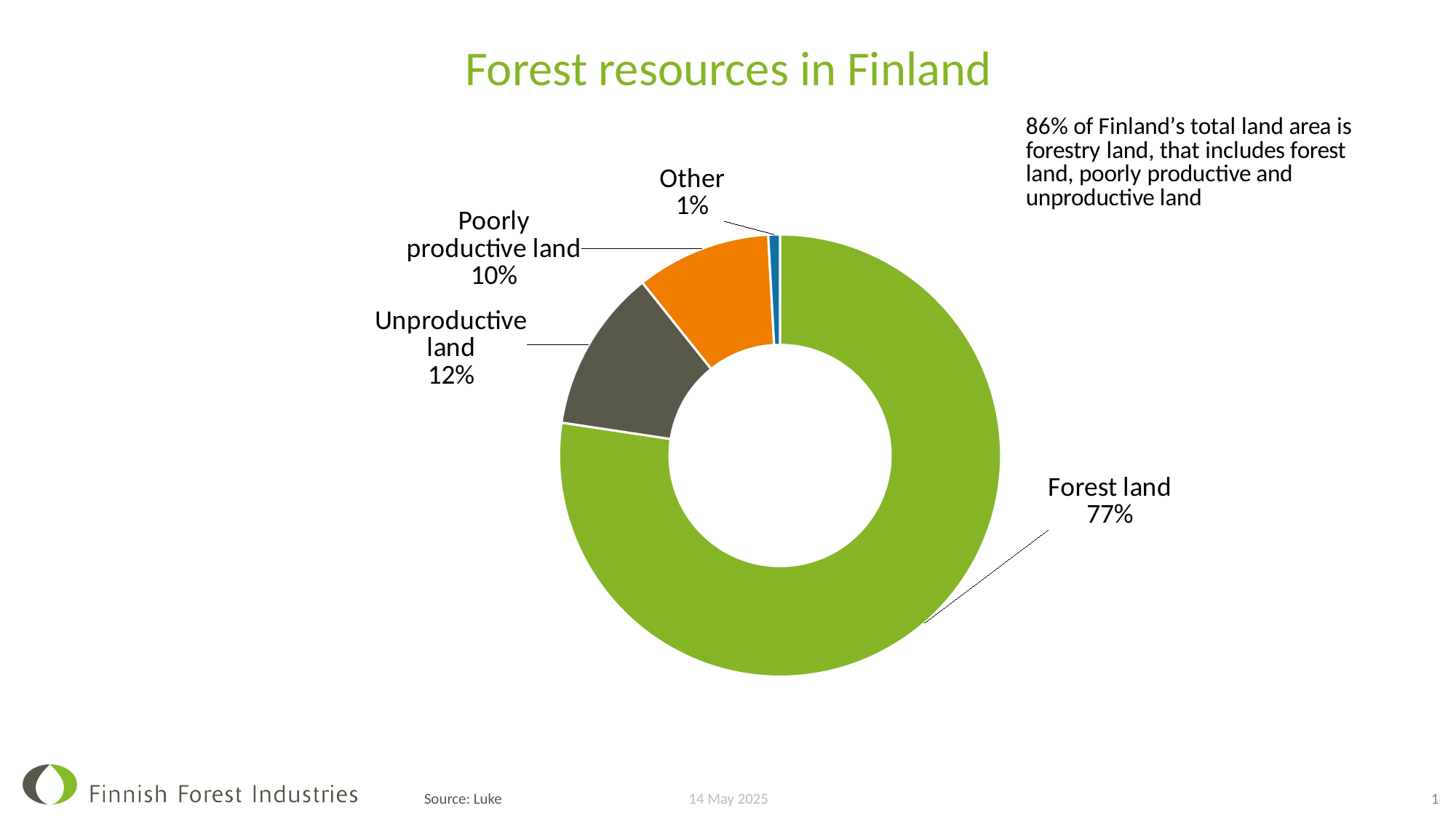
What share of the chart is Other? 1% Which category has the smallest share of the chart? Other How many categories are shown in the chart? 4 Which category has the largest share of the chart? Forest land What kind of chart is shown on the slide? Doughnut (pie) chart What share of the chart is Forest land? 77% Which is larger, the share for Unproductive land or the share for Poorly productive land? Unproductive land What is the difference in percentage points between Forest land and Unproductive land? 65 What is the difference in percentage points between Unproductive land and Poorly productive land? 2 What share of the chart is Unproductive land? 12% What share of the chart is Poorly productive land? 10% What is the title of the slide? Forest resources in Finland